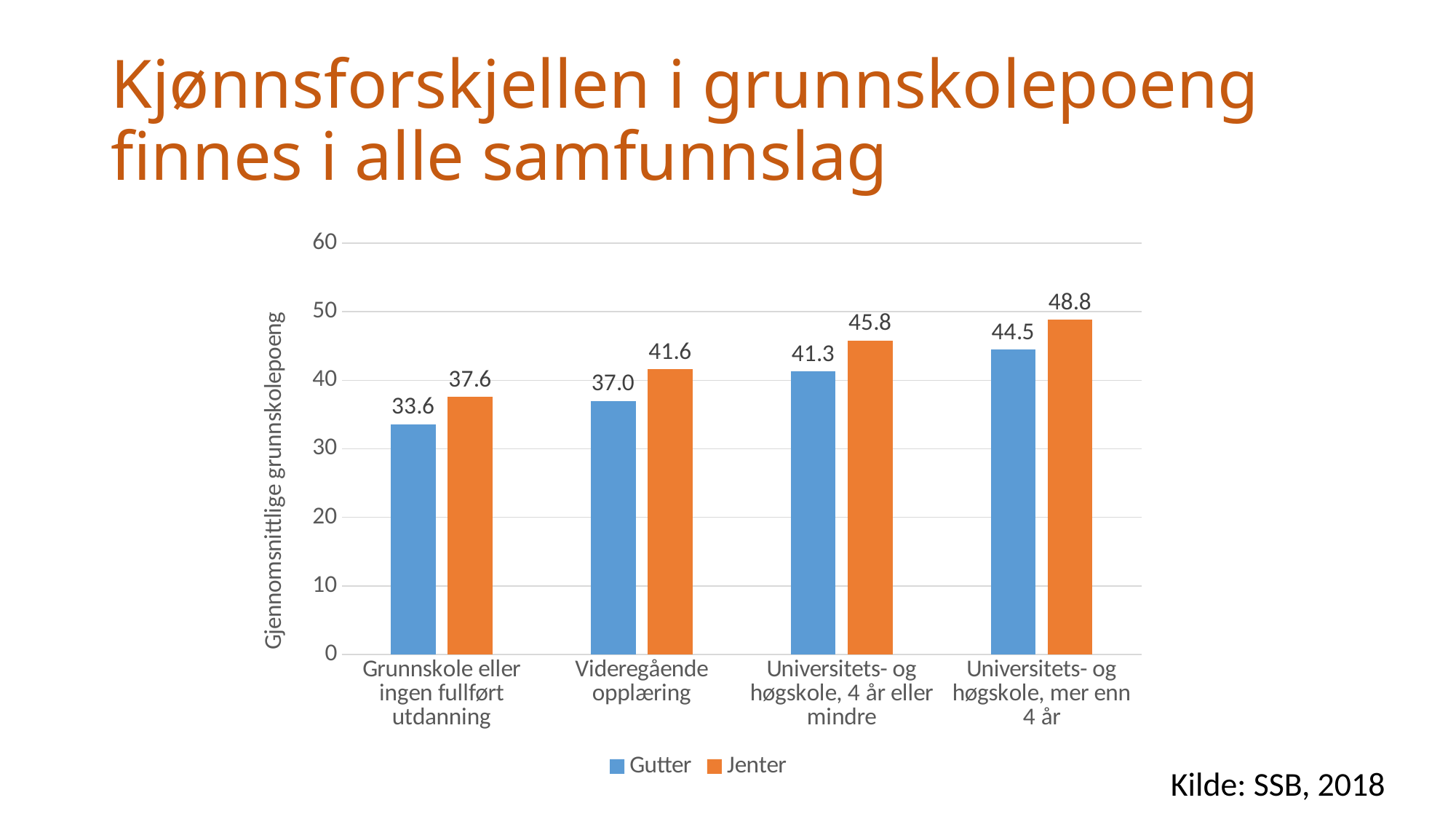
What is the value for Gutter in the category 'Universitets- og høgskole, mer enn 4 år'? 44.5 What is the difference between Jenter and Gutter in the category 'Universitets- og høgskole, 4 år eller mindre'? 4.5 How many series does the legend list? 2 Is the value for Jenter in 'Universitets- og høgskole, mer enn 4 år' greater or less than 50? less How many categories are shown on the x axis? 4 What is the value for Gutter in the category 'Grunnskole eller ingen fullført utdanning'? 33.6 Which is larger in the category 'Videregående opplæring': Gutter or Jenter? Jenter Do the values for Gutter rise or fall from left to right across the categories? rise Which category has the highest value for Jenter? Universitets- og høgskole, mer enn 4 år What kind of chart is shown on the slide? bar chart Which category has the lowest value for Gutter? Grunnskole eller ingen fullført utdanning What is the value for Jenter in the category 'Videregående opplæring'? 41.6